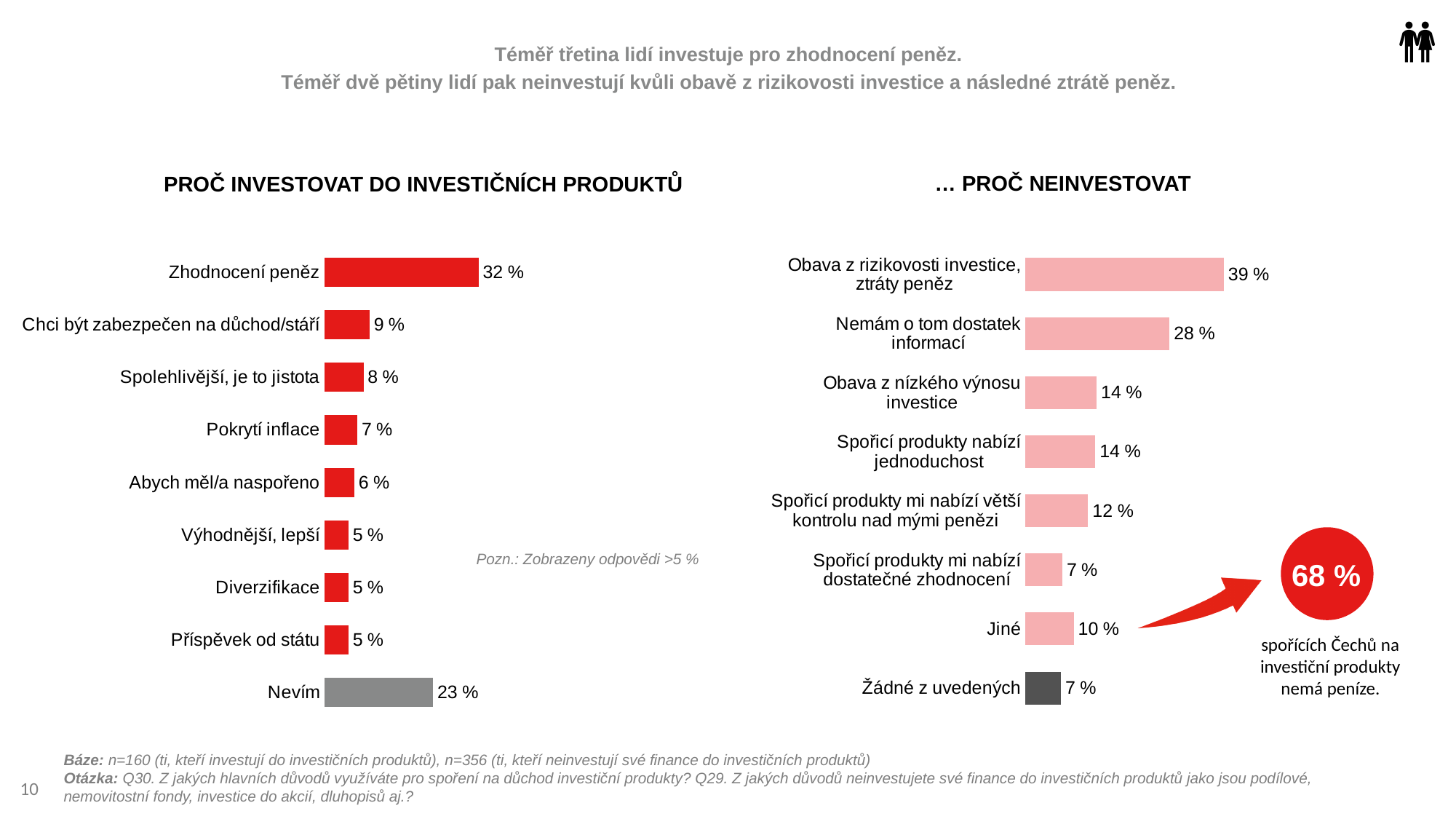
In the chart 'PROČ INVESTOVAT DO INVESTIČNÍCH PRODUKTŮ', which category has the highest value? Zhodnocení peněz In the chart 'PROČ INVESTOVAT DO INVESTIČNÍCH PRODUKTŮ', what is the difference between 'Zhodnocení peněz' and 'Chci být zabezpečen na důchod/stáří'? 23 % What kind of chart is 'PROČ INVESTOVAT DO INVESTIČNÍCH PRODUKTŮ'? Bar chart In the chart '… PROČ NEINVESTOVAT', how many categories are shown? 8 In the chart '… PROČ NEINVESTOVAT', which category has the highest value? Obava z rizikovosti investice, ztráty peněz In the chart 'PROČ INVESTOVAT DO INVESTIČNÍCH PRODUKTŮ', how many categories are shown? 9 In the chart '… PROČ NEINVESTOVAT', which is larger: 'Jiné' or 'Žádné z uvedených'? Jiné In the chart '… PROČ NEINVESTOVAT', what is the difference between 'Obava z rizikovosti investice, ztráty peněz' and 'Nemám o tom dostatek informací'? 11 % In the chart 'PROČ INVESTOVAT DO INVESTIČNÍCH PRODUKTŮ', what is the value for 'Nevím'? 23 % In the chart '… PROČ NEINVESTOVAT', what is the value for 'Nemám o tom dostatek informací'? 28 % In the chart 'PROČ INVESTOVAT DO INVESTIČNÍCH PRODUKTŮ', what is the value for 'Zhodnocení peněz'? 32 % In the chart '… PROČ NEINVESTOVAT', what is the value for 'Obava z rizikovosti investice, ztráty peněz'? 39 %